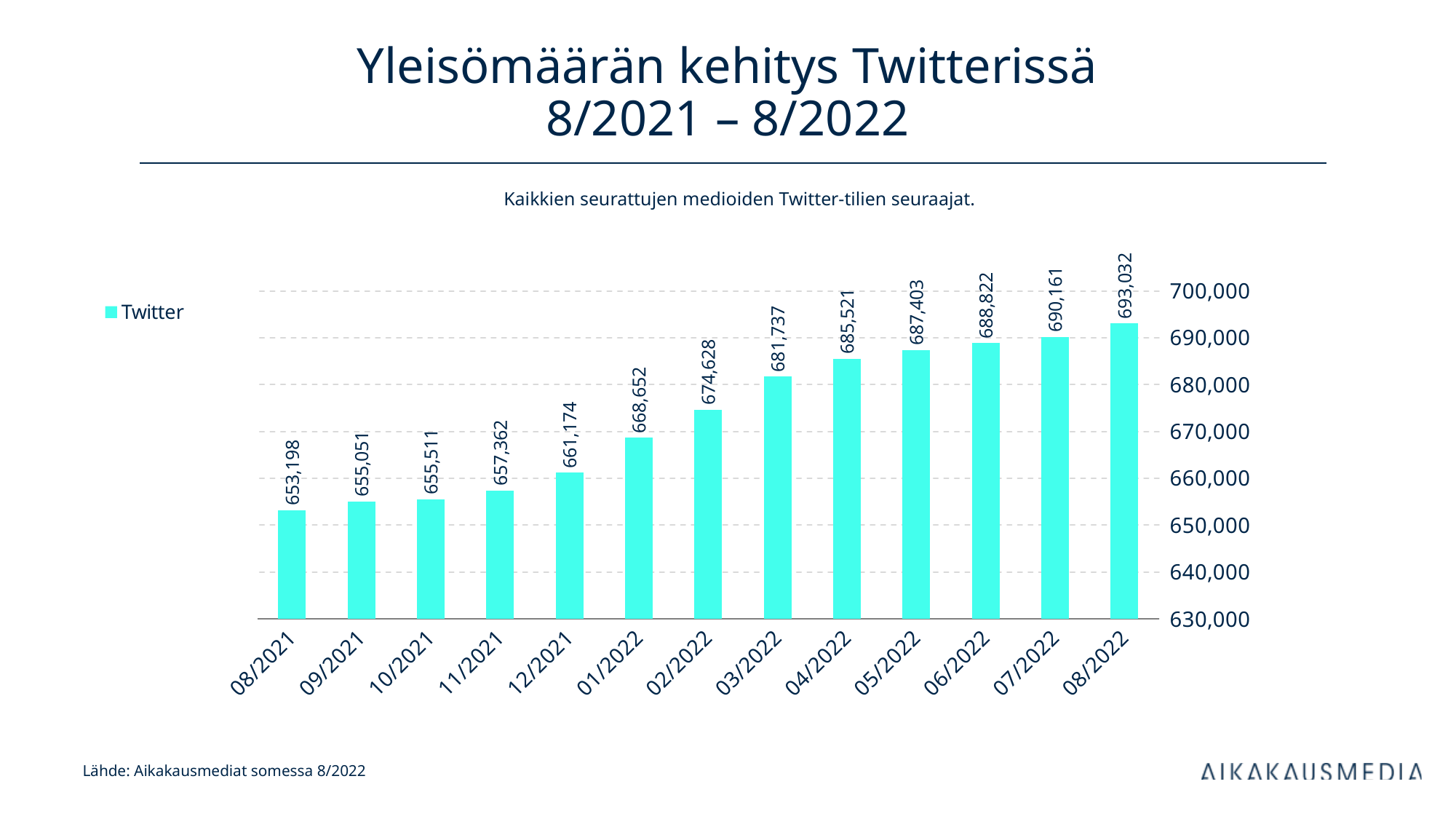
What is the value for 08/2022? 693,032 How many months are shown on the x axis? 13 Do the values rise or fall from 08/2021 to 08/2022? rise What is the value for 02/2022? 674,628 Which is larger, the value for 03/2022 or the value for 04/2022? 04/2022 What is the difference between the values for 01/2022 and 12/2021? 7,478 What kind of chart is shown on the slide? bar chart Which month has the highest value? 08/2022 Is the value for 11/2021 greater or less than 660,000? less What is the value for 08/2021? 653,198 Which month has the lowest value? 08/2021 What is the difference between the values for 08/2022 and 08/2021? 39,834